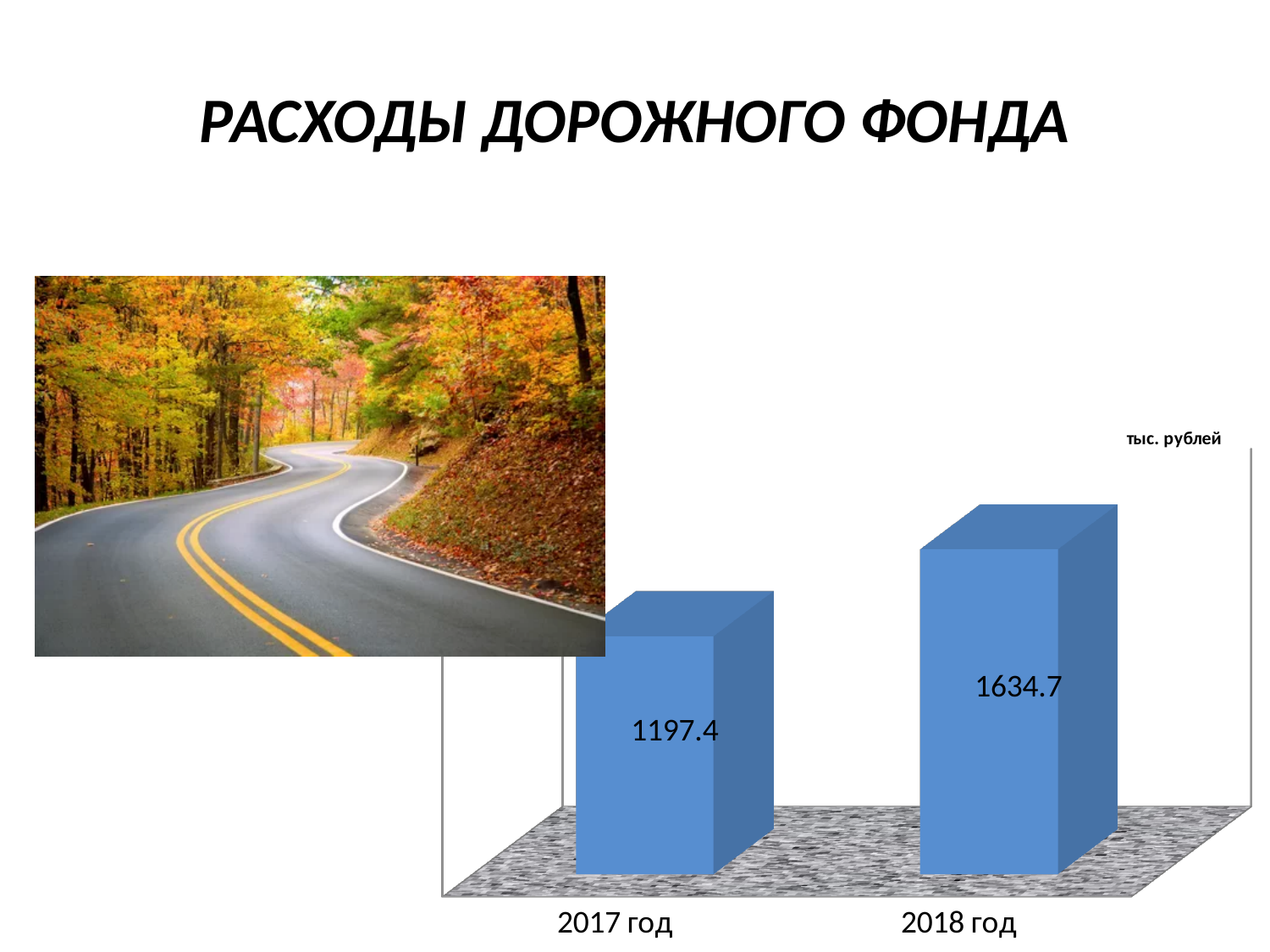
What is the value for 2017 год? 1197.4 What unit is indicated for the chart values? тыс. рублей What is the difference between the values for 2018 год and 2017 год? 437.3 Which year has the highest value? 2018 год Which year has the lowest value? 2017 год How many categories are shown in the chart? 2 What is the value for 2018 год? 1634.7 Which is larger, the value for 2017 год or the value for 2018 год? 2018 год What kind of chart is shown on the slide? bar chart What is the title of the slide? РАСХОДЫ ДОРОЖНОГО ФОНДА Do the values rise or fall from 2017 год to 2018 год? rise